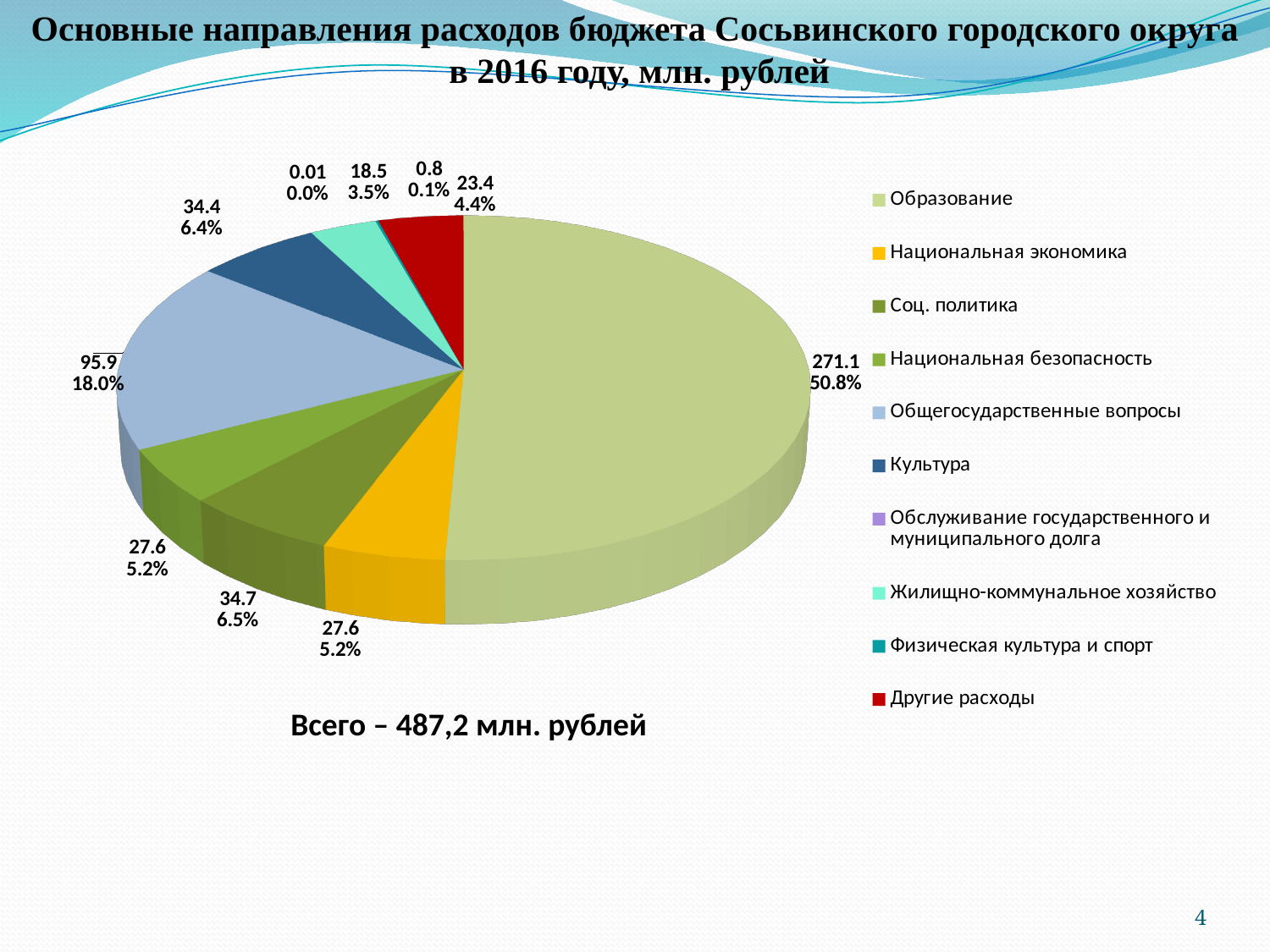
Which is larger, the value for Соц. политика or the value for Другие расходы? Соц. политика Which category has the largest slice of the pie? Образование What is the value shown for Образование? 271.1 What is the difference between the values for Общегосударственные вопросы (95.9) and Культура (34.4)? 61.5 What share of the pie does Образование account for? 50.8% What is the value shown for Жилищно-коммунальное хозяйство? 18.5 How many categories does the legend of the pie chart list? 10 Which category has the smallest slice of the pie? Обслуживание государственного и муниципального долга What kind of chart is shown on the slide? pie chart What is the value shown for Общегосударственные вопросы? 95.9 What percentage is shown for Общегосударственные вопросы? 18.0% What total amount is stated below the pie chart? 487,2 млн. рублей